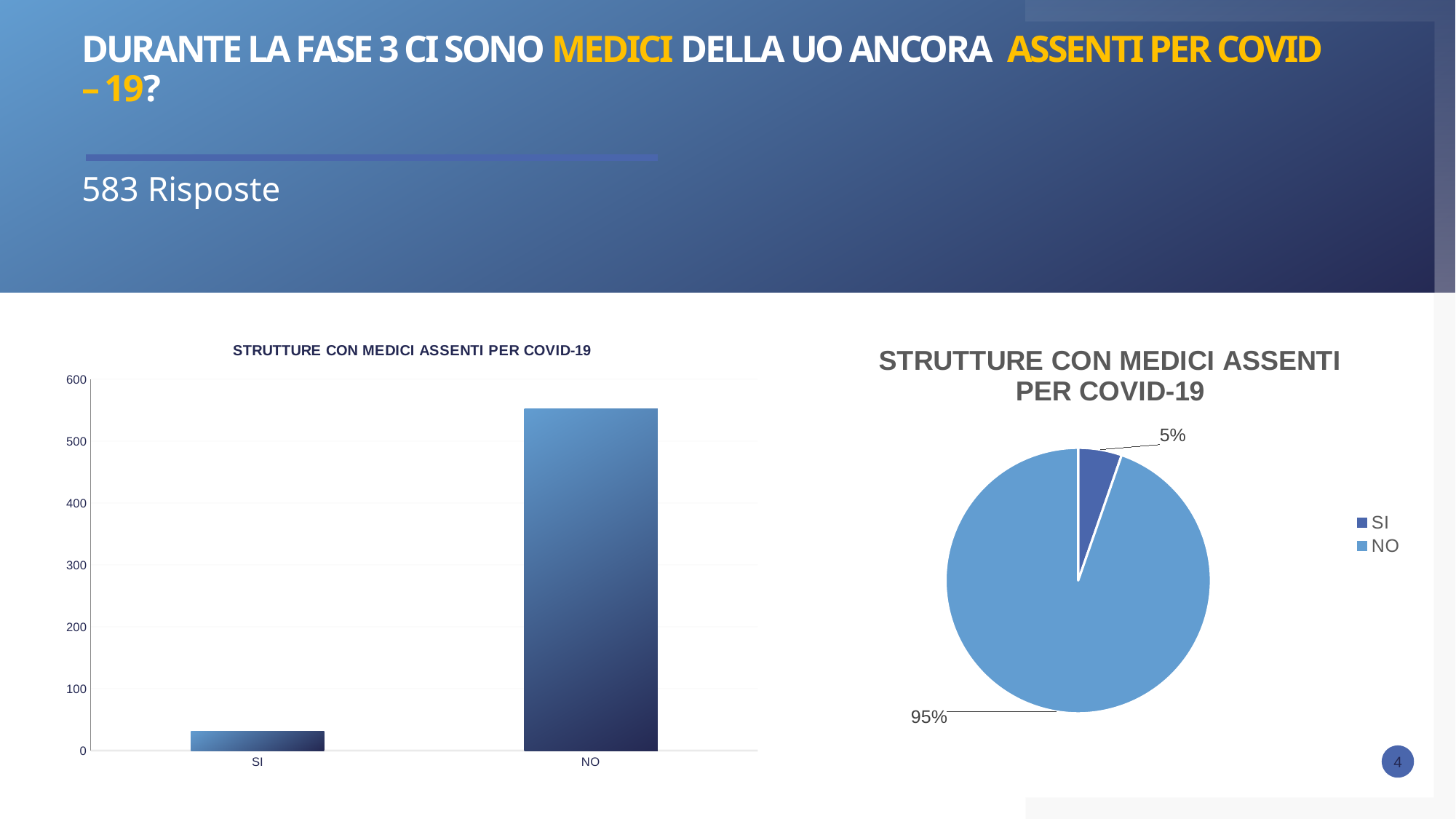
What kind of chart is the right chart titled 'STRUTTURE CON MEDICI ASSENTI PER COVID-19'? pie chart In the right pie chart, which slice is larger, SI or NO? NO In the right pie chart, what is the difference in percentage points between the NO share and the SI share? 90 In the right pie chart, what share of the pie does the SI slice represent? 5% In the left bar chart, which category has the highest bar? NO What kind of chart is the left chart titled 'STRUTTURE CON MEDICI ASSENTI PER COVID-19'? bar chart In the left bar chart, how many categories are shown on the x axis? 2 In the right pie chart, how many entries does the legend list? 2 In the right pie chart, what share of the pie does the NO slice represent? 95% In the left bar chart, is the value for NO greater or less than 500? greater In the left bar chart, is the value for SI greater or less than 100? less In the left bar chart, which category has the lowest bar? SI